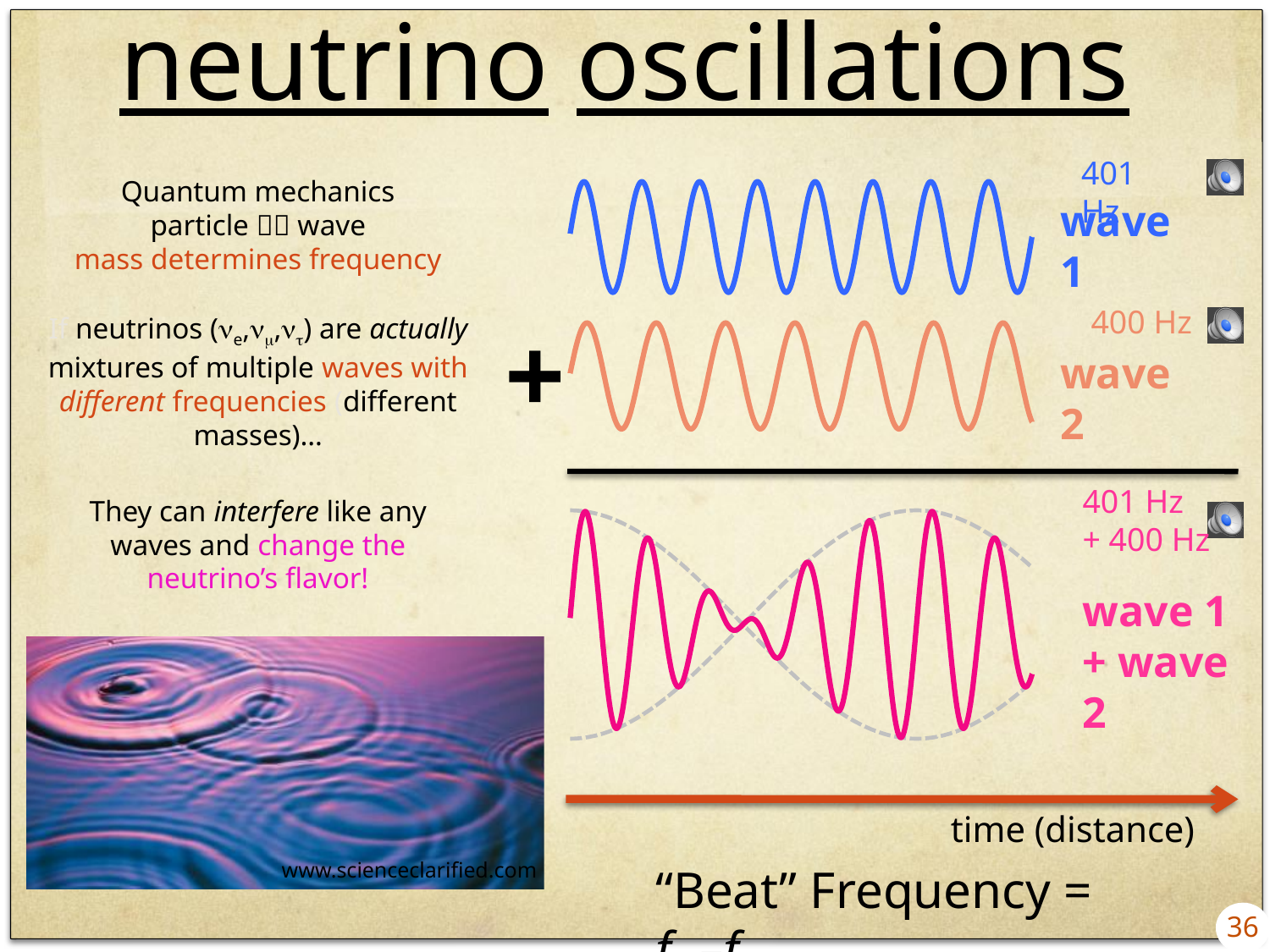
What is the label on the horizontal arrow axis beneath the bottom wave plot? time (distance) What frequency is labelled for wave 1 (the top blue wave)? 401 Hz How many separate wave plots are shown on the right side of the slide? 3 What kind of chart are the wave plots on the right side of the slide? line chart What is the difference between the labelled frequencies of wave 1 and wave 2? 1 Hz Which has the higher labelled frequency, wave 1 or wave 2? wave 1 What frequency is labelled for wave 2 (the middle orange wave)? 400 Hz What frequencies are labelled for the bottom pink wave (wave 1 + wave 2)? 401 Hz + 400 Hz What colour is the wave 1 + wave 2 plot? pink